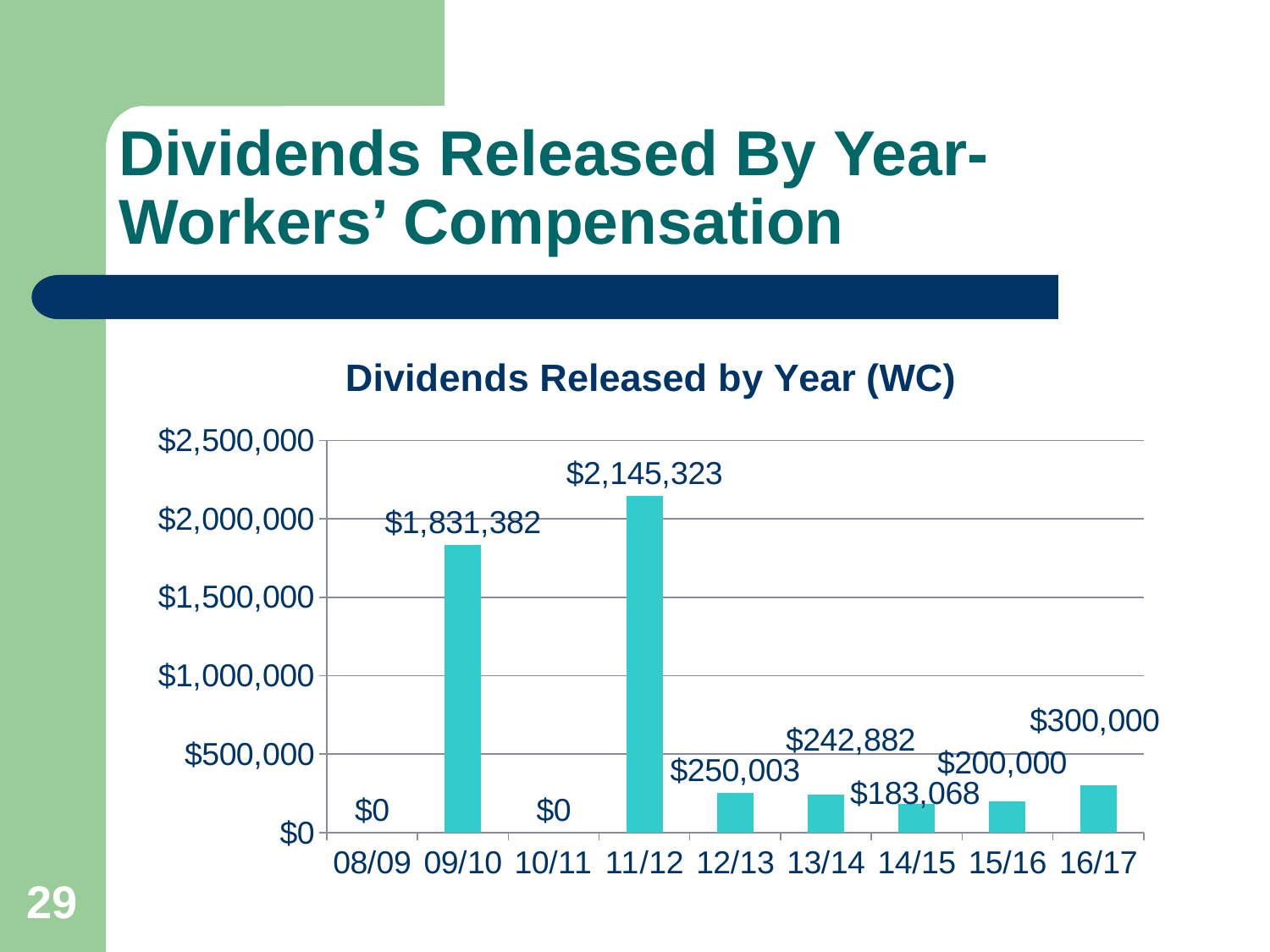
Which year has the larger dividend released, 12/13 or 13/14? 12/13 Is the value for 09/10 greater or less than $1,500,000? greater Do the values rise or fall from 11/12 to 14/15? fall What is the dividend released for 09/10? $1,831,382 What is the dividend released for 11/12? $2,145,323 Which year has the highest dividend released? 11/12 What kind of chart is shown on the slide? bar chart What is the dividend released for 14/15? $183,068 What is the difference between the dividends released in 11/12 and 09/10? $313,941 What is the difference between the dividends released in 16/17 and 15/16? $100,000 How many years are shown on the x axis? 9 What is the dividend released for 16/17? $300,000